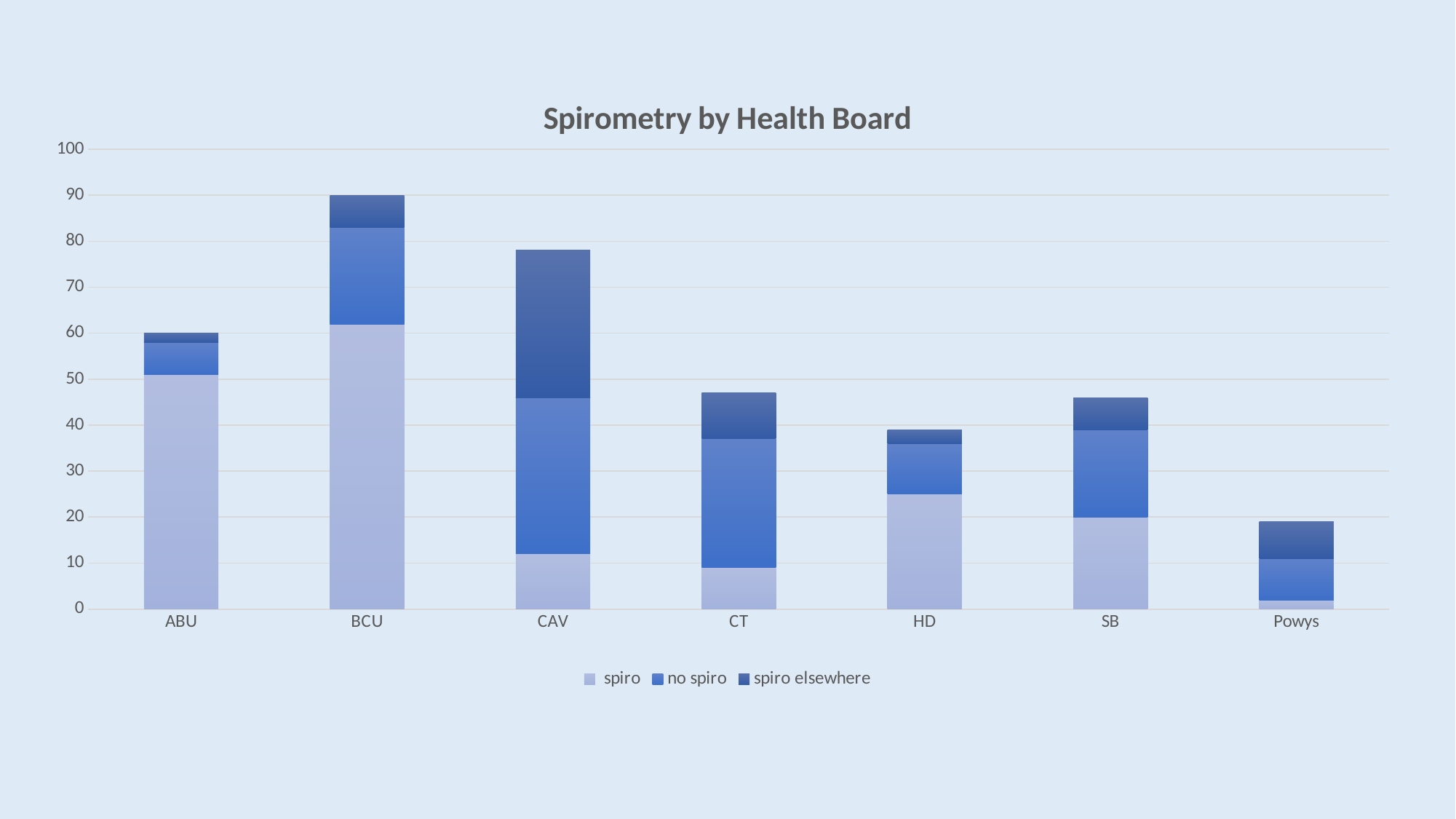
How many health boards are shown on the x axis? 7 Is the total stacked value for Powys greater or less than 30? less Which health board has the tallest stacked bar overall? BCU Which series is listed last in the legend? spiro elsewhere Is the total stacked value for ABU greater or less than 50? greater What kind of chart is shown on the slide? stacked bar chart Which health board has the largest 'spiro' segment? BCU Is the total stacked value for BCU greater or less than 80? greater What is the title of the chart? Spirometry by Health Board Which health board has the shortest stacked bar overall? Powys How many series does the legend list? 3 Which has the larger total stacked bar, BCU or CAV? BCU